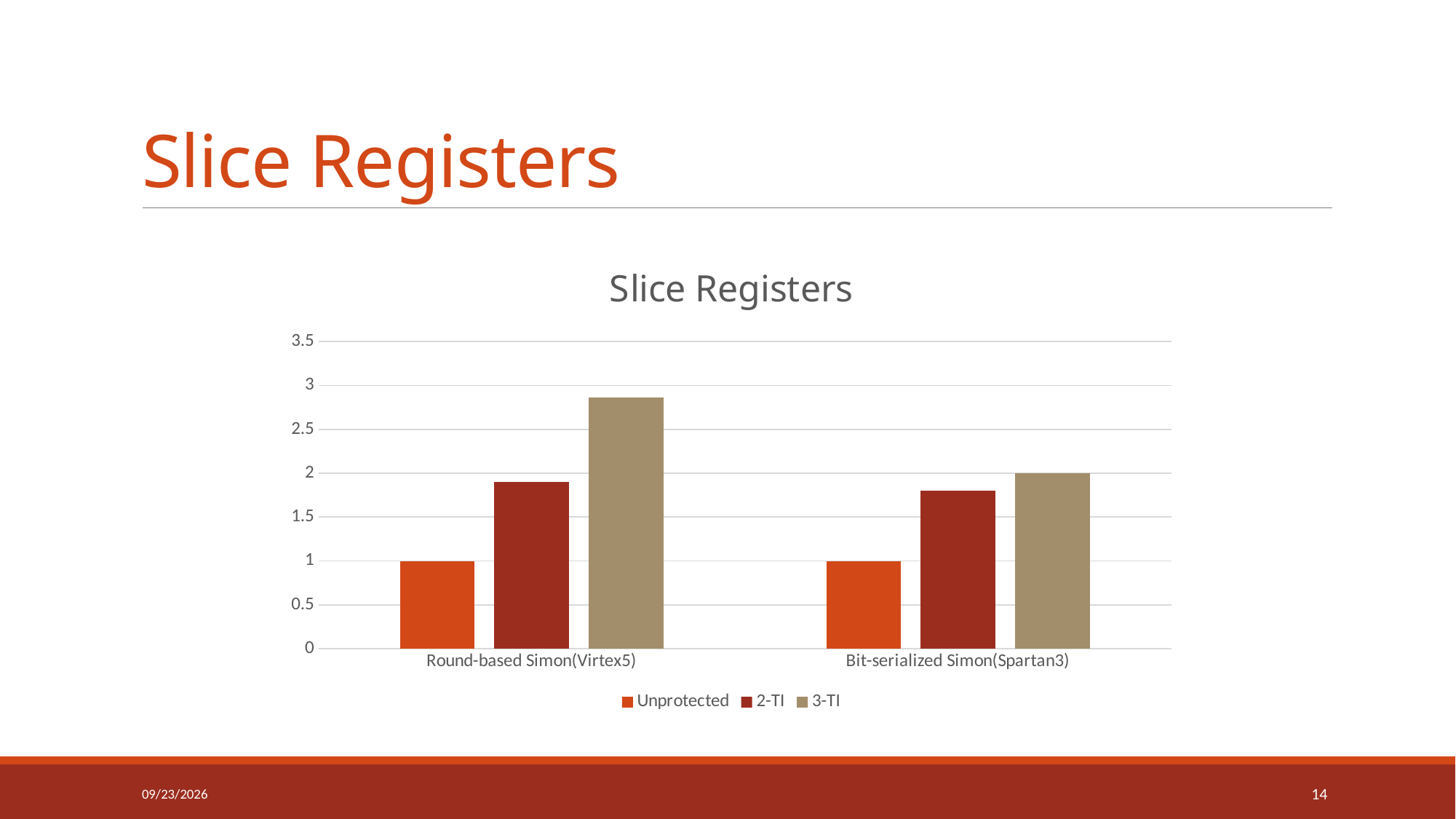
Is the 2-TI value for Bit-serialized Simon(Spartan3) greater or less than 2? less What is the Unprotected value for Round-based Simon(Virtex5)? 1 Is the 3-TI value for Round-based Simon(Virtex5) greater or less than 2.5? greater Which series is shown in the tan/beige colour in the legend? 3-TI What kind of chart is shown on the slide? bar chart Which is larger: the 3-TI value for Round-based Simon(Virtex5) or the 3-TI value for Bit-serialized Simon(Spartan3)? Round-based Simon(Virtex5) What is the Unprotected value for Bit-serialized Simon(Spartan3)? 1 What is the title of the chart? Slice Registers How many categories are shown on the x axis? 2 Which series has the highest value for Round-based Simon(Virtex5)? 3-TI Which series has the lowest value for Bit-serialized Simon(Spartan3)? Unprotected How many series does the legend list? 3